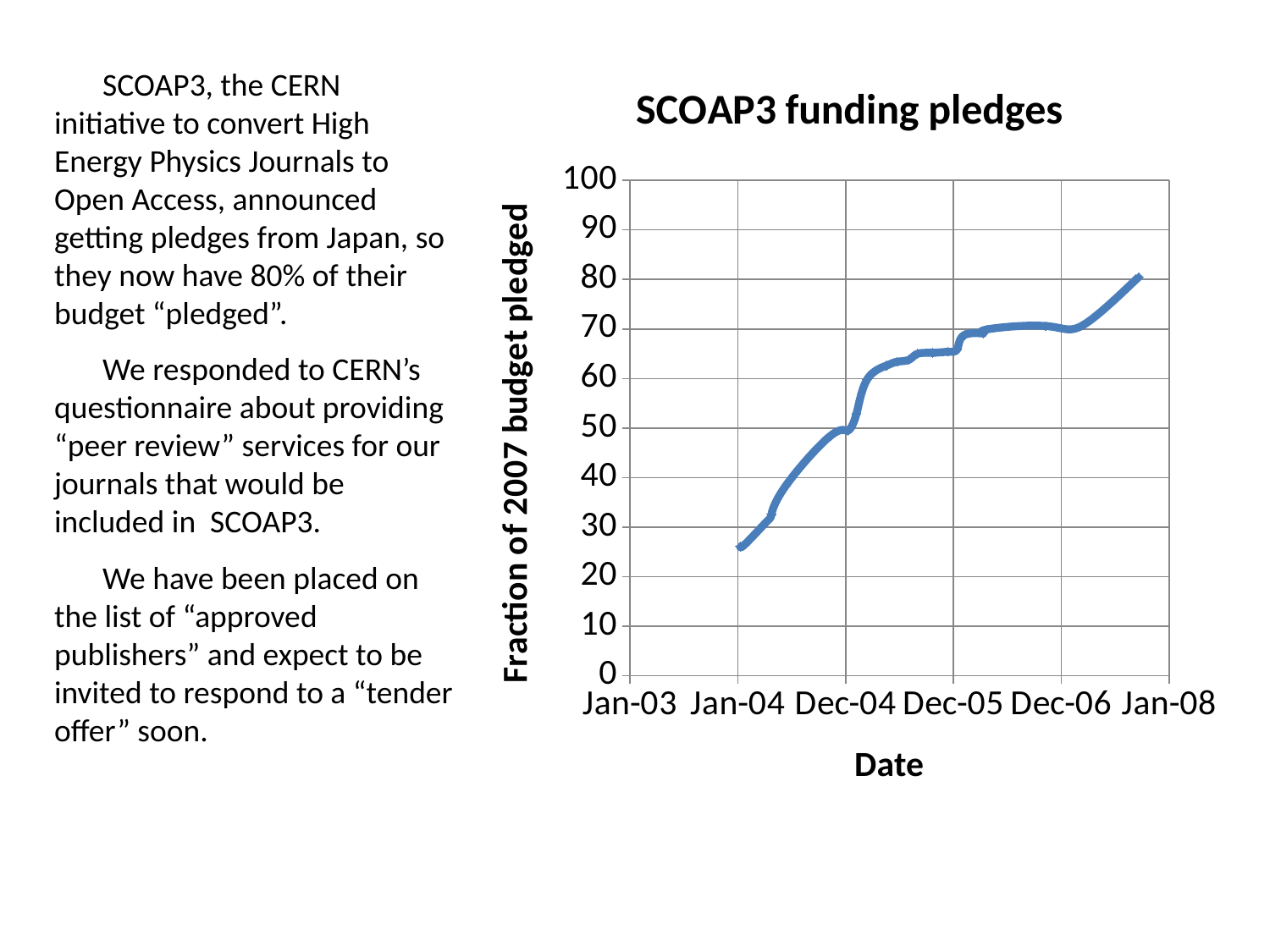
Is the value at Dec-06 greater or less than 60? greater Do the values in the chart generally rise or fall from Jan-04 to Jan-08? rise Which date has the higher value, Dec-04 or Jan-08? Jan-08 Is the value at Jan-04 greater or less than 20? greater Is the value at Jan-04 greater or less than 30? less What is the title of the chart? SCOAP3 funding pledges What is the label of the vertical axis of the chart? Fraction of 2007 budget pledged Which date has the higher value, Jan-04 or Dec-05? Dec-05 What kind of chart is shown on the slide? line chart What is the highest value shown on the vertical axis of the chart? 100